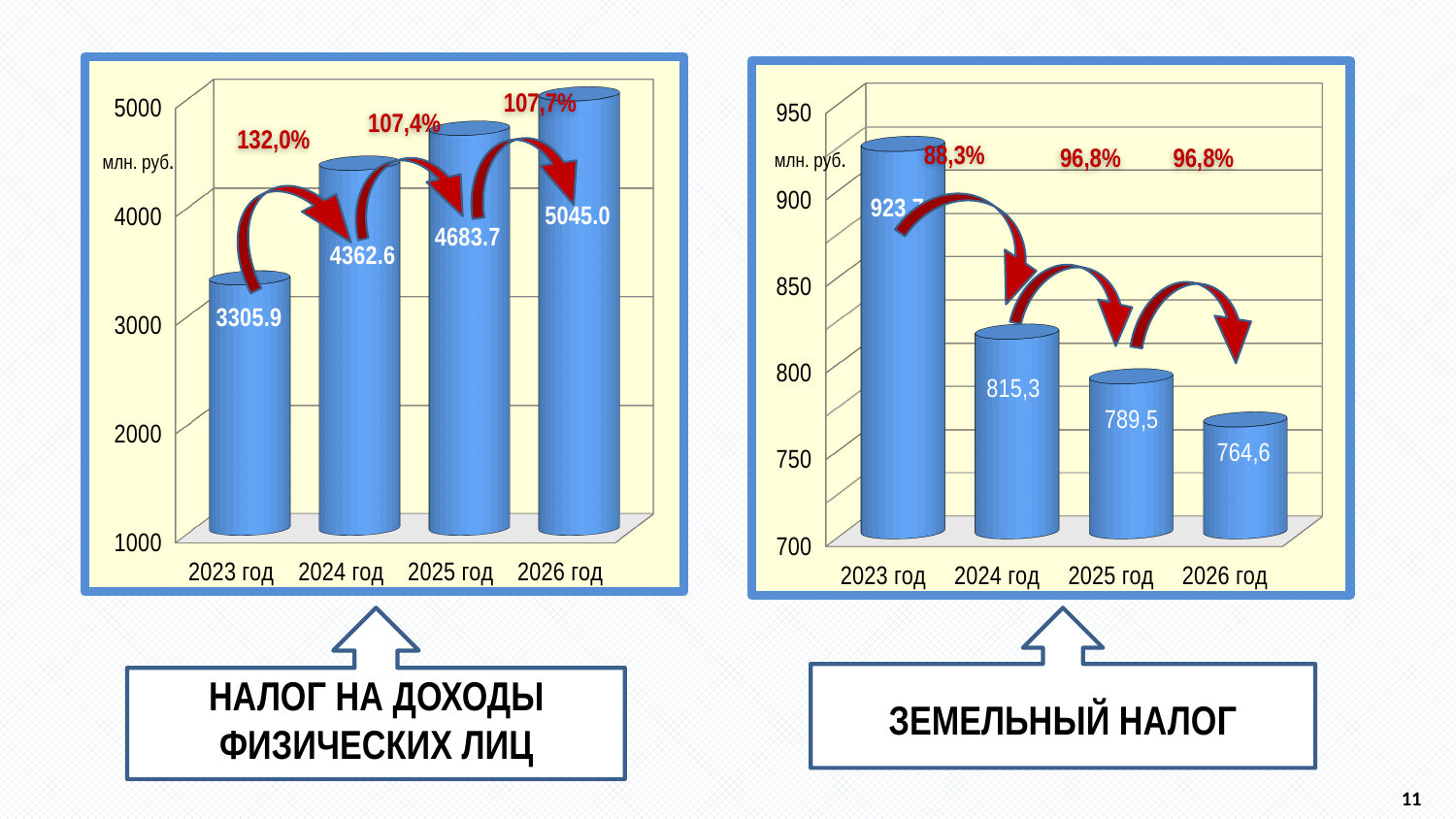
In the ЗЕМЕЛЬНЫЙ НАЛОГ chart, which year has the highest value? 2023 год In the НАЛОГ НА ДОХОДЫ ФИЗИЧЕСКИХ ЛИЦ chart, what is the value for 2026 год? 5045.0 In the НАЛОГ НА ДОХОДЫ ФИЗИЧЕСКИХ ЛИЦ chart, what is the value for 2024 год? 4362.6 In the ЗЕМЕЛЬНЫЙ НАЛОГ chart, what is the value for 2025 год? 789,5 In the НАЛОГ НА ДОХОДЫ ФИЗИЧЕСКИХ ЛИЦ chart, what is the difference between the 2026 год and 2023 год values? 1739.1 In the ЗЕМЕЛЬНЫЙ НАЛОГ chart, what is the value for 2026 год? 764,6 In the НАЛОГ НА ДОХОДЫ ФИЗИЧЕСКИХ ЛИЦ chart, which year has the lowest value? 2023 год How many years are shown in the НАЛОГ НА ДОХОДЫ ФИЗИЧЕСКИХ ЛИЦ chart? 4 In the ЗЕМЕЛЬНЫЙ НАЛОГ chart, is the value for 2024 год greater or less than 800? greater In the НАЛОГ НА ДОХОДЫ ФИЗИЧЕСКИХ ЛИЦ chart, what percentage is shown in red above the arrow from 2023 год to 2024 год? 132,0% Do the values in the ЗЕМЕЛЬНЫЙ НАЛОГ chart rise or fall from 2023 год to 2026 год? fall In the ЗЕМЕЛЬНЫЙ НАЛОГ chart, what is the difference between the 2024 год and 2026 год values? 50,7